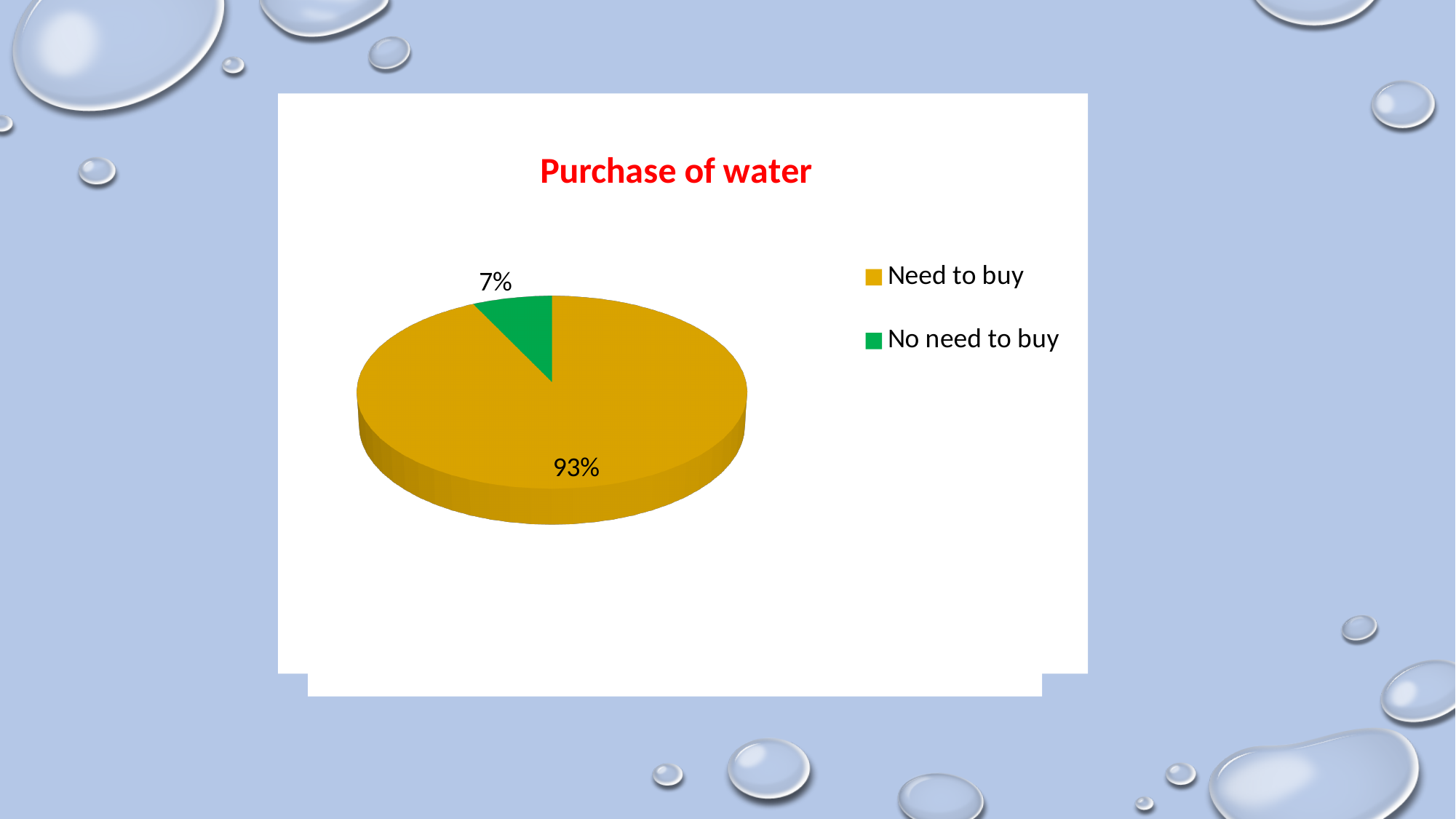
What share of the pie is labelled "No need to buy"? 7% How many entries does the legend list? 2 What kind of chart is shown on the slide? pie chart Which category has the smallest slice of the pie? No need to buy Which category has the largest slice of the pie? Need to buy What share of the pie is labelled "Need to buy"? 93% Which is larger, the share for "Need to buy" or the share for "No need to buy"? Need to buy How many slices does the pie chart have? 2 What colour is the "No need to buy" slice? green What is the title of the chart? Purchase of water What is the difference in percentage points between "Need to buy" and "No need to buy"? 86